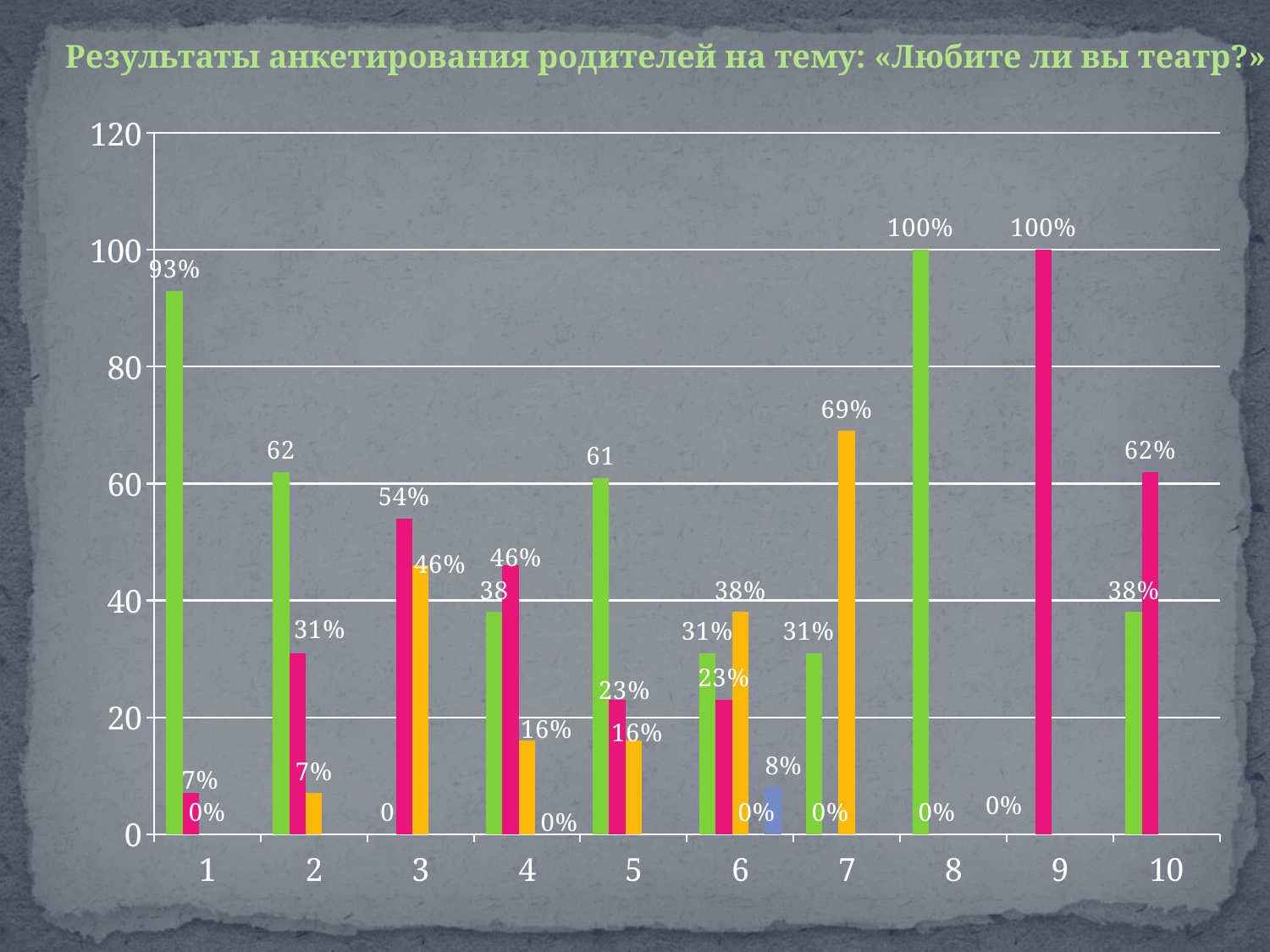
What is the value of the green bar for category 1? 93% What is the value of the blue bar for category 6? 8% What is the difference between the green bar and the pink bar for category 1? 86% How many categories are shown on the x axis? 10 What is the title of the chart? Результаты анкетирования родителей на тему: «Любите ли вы театр?» Which category has the highest pink bar? 9 Which is larger for category 5, the green bar or the pink bar? the green bar What is the value of the pink bar for category 3? 54% What is the value of the orange bar for category 7? 69% What kind of chart is shown on the slide? bar chart Which is larger for category 10, the green bar or the pink bar? the pink bar Which category has the highest green bar? 8